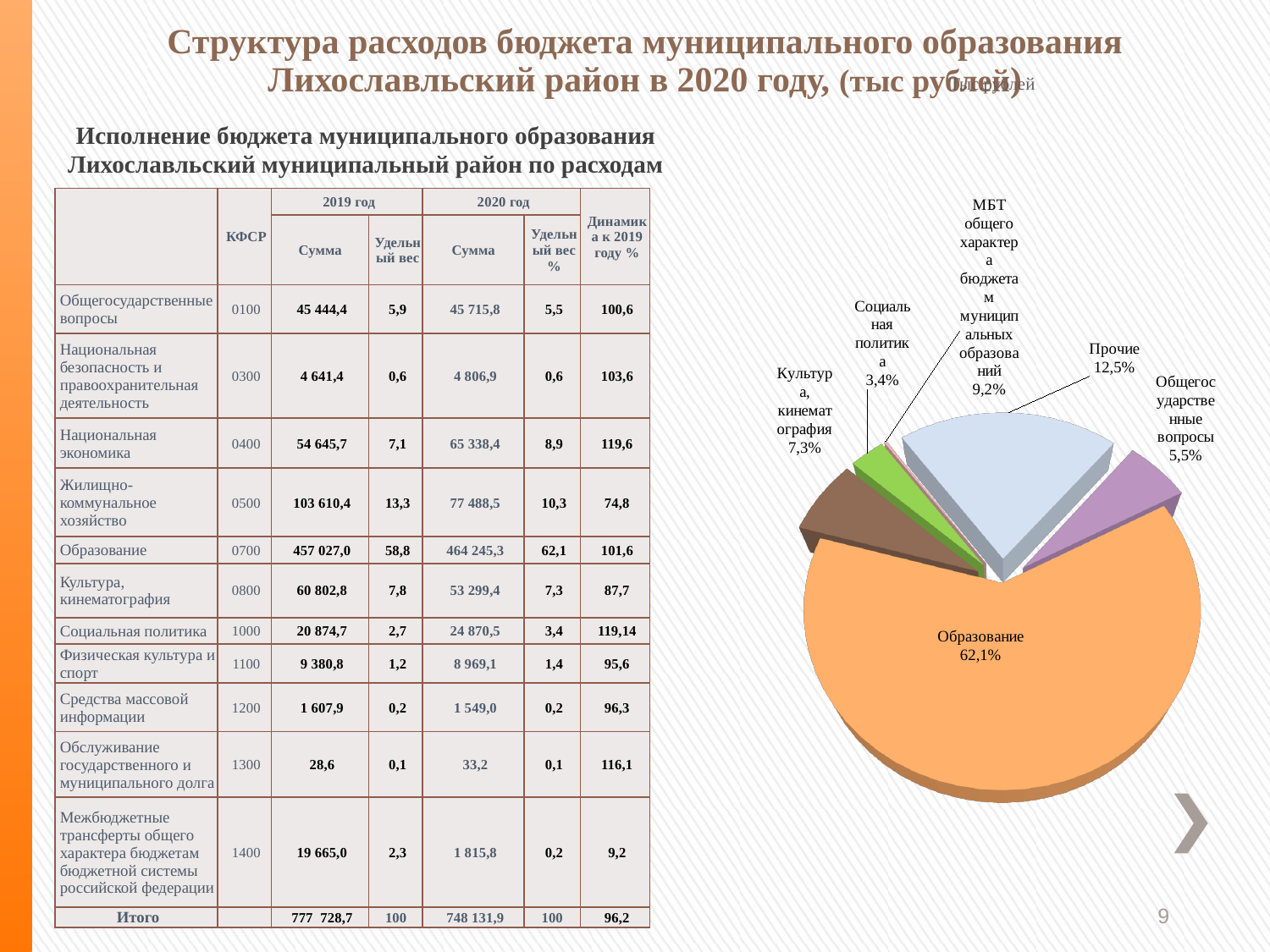
In the pie chart, what colour is the Образование slice? orange How many slices does the pie chart have? 6 In the pie chart, what is the difference between the shares of Образование and Прочие? 49,6% Which slice of the pie chart is the largest? Образование In the pie chart, what share is labelled for Культура, кинематография? 7,3% In the pie chart, what share is labelled for Образование? 62,1% In the pie chart, what share is labelled for Общегосударственные вопросы? 5,5% In the pie chart, which is larger: Прочие or Культура, кинематография? Прочие In the pie chart, what share is labelled for Прочие? 12,5% What kind of chart is shown on the right side of the slide? pie chart In the pie chart, what share is labelled for Социальная политика? 3,4%